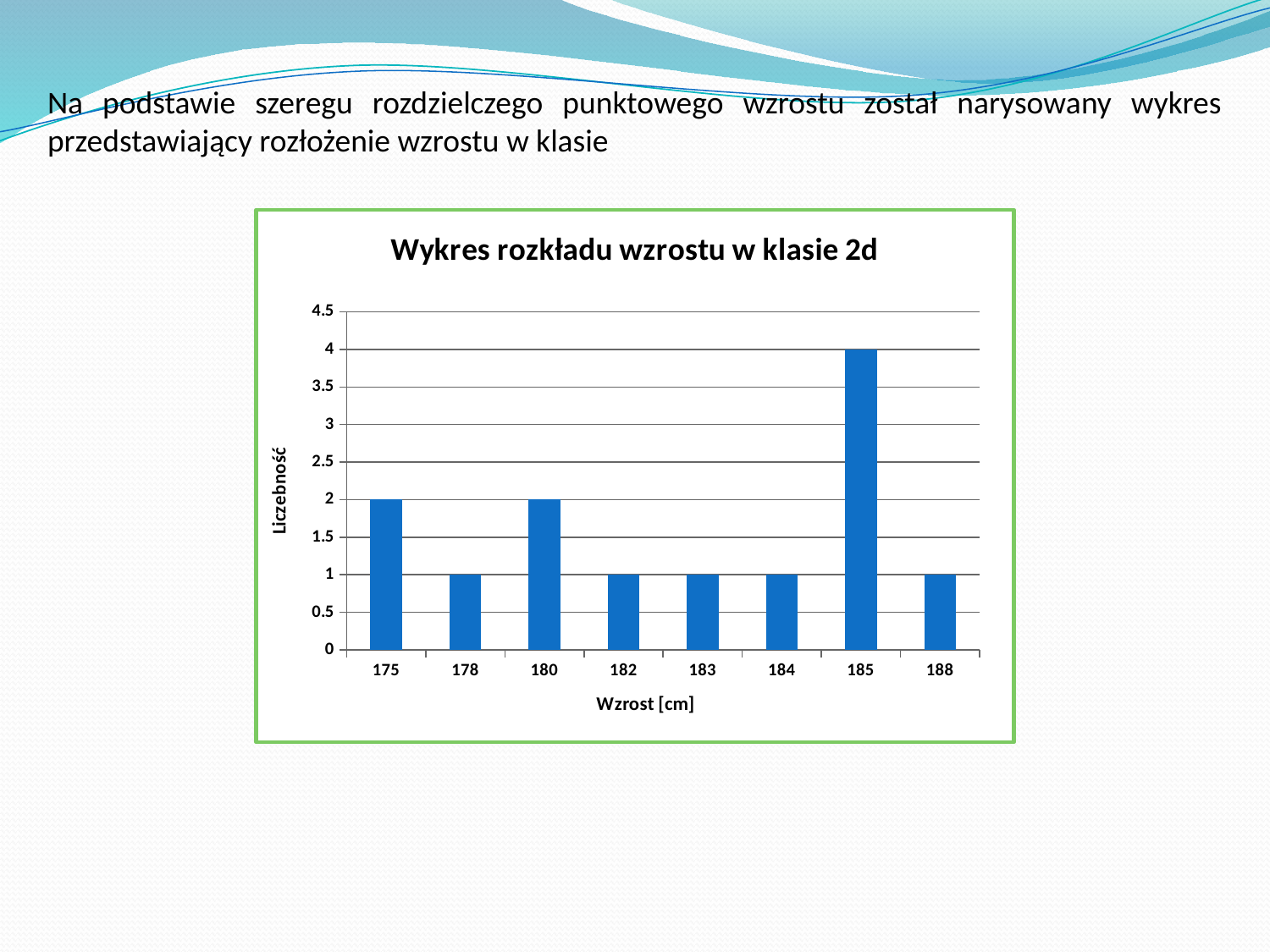
Which height has the highest Liczebność? 185 What is the value (Liczebność) for the height 178 cm? 1 Is the value for 185 cm greater or less than 3? greater What type of chart is shown on the slide? bar chart How many height categories are shown on the x axis? 8 What is the value (Liczebność) for the height 180 cm? 2 What is the value (Liczebność) for the height 185 cm? 4 What is the value (Liczebność) for the height 175 cm? 2 Which has a larger value, 185 cm or 180 cm? 185 What is the difference between the values for 185 cm and 175 cm? 2 What is the title of the chart? Wykres rozkładu wzrostu w klasie 2d What is the label of the x axis? Wzrost [cm]